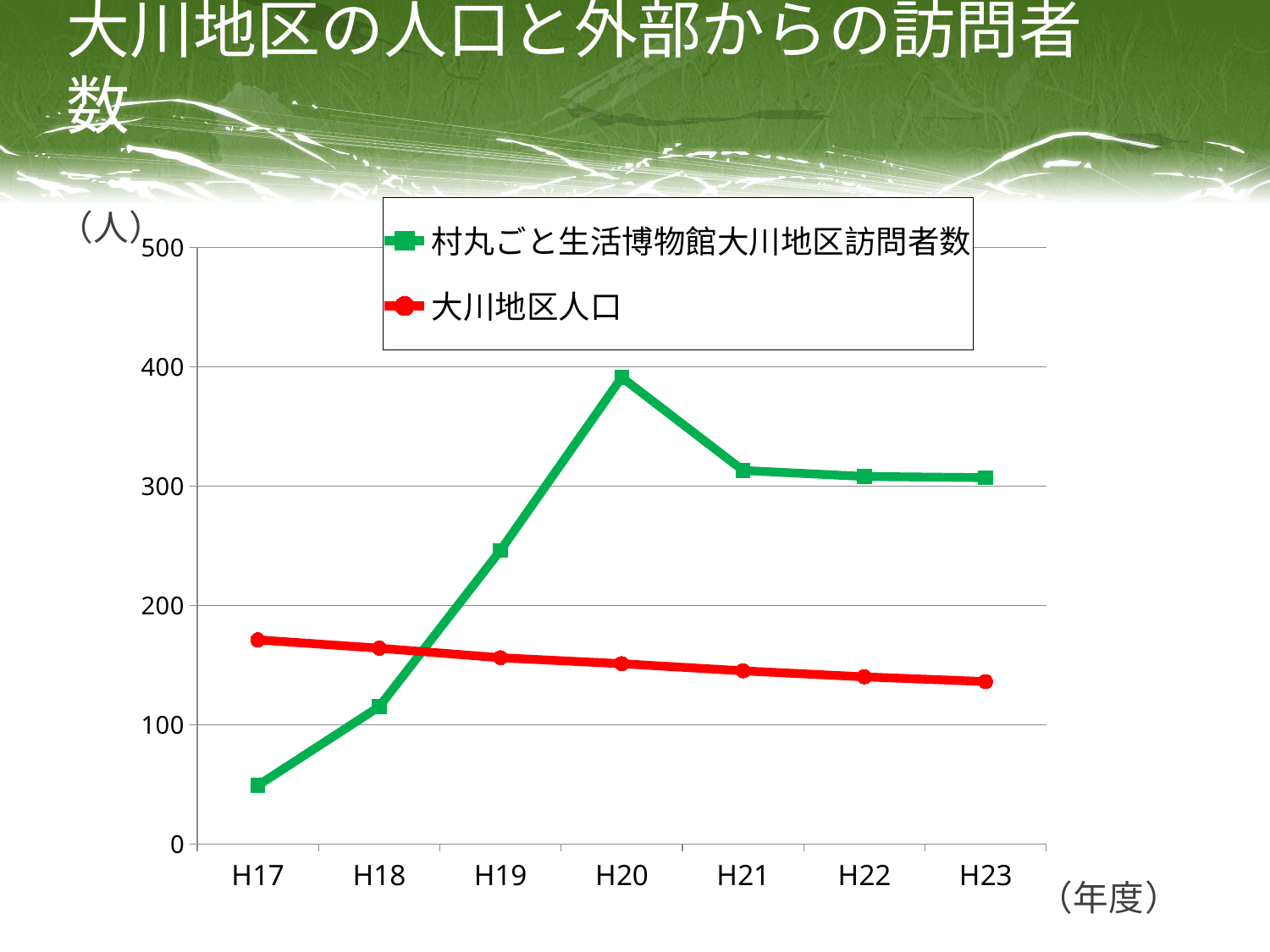
How many years (categories) are plotted along the x axis? 7 In which year is the 大川地区人口 series at its highest? H17 What kind of chart is shown on the slide? line chart How many series does the legend list? 2 In H21, which series has the larger value, 村丸ごと生活博物館大川地区訪問者数 or 大川地区人口? 村丸ごと生活博物館大川地区訪問者数 Does the 大川地区人口 series rise or fall from H17 to H23? fall Is the value of 村丸ごと生活博物館大川地区訪問者数 in H20 greater or less than 300? greater Is the value of 大川地区人口 in H23 greater or less than 200? less Which colour is used for the 大川地区人口 series? red In which year is the 村丸ごと生活博物館大川地区訪問者数 series at its highest? H20 Is the value of 村丸ごと生活博物館大川地区訪問者数 in H17 greater or less than 100? less In which year is the 村丸ごと生活博物館大川地区訪問者数 series at its lowest? H17